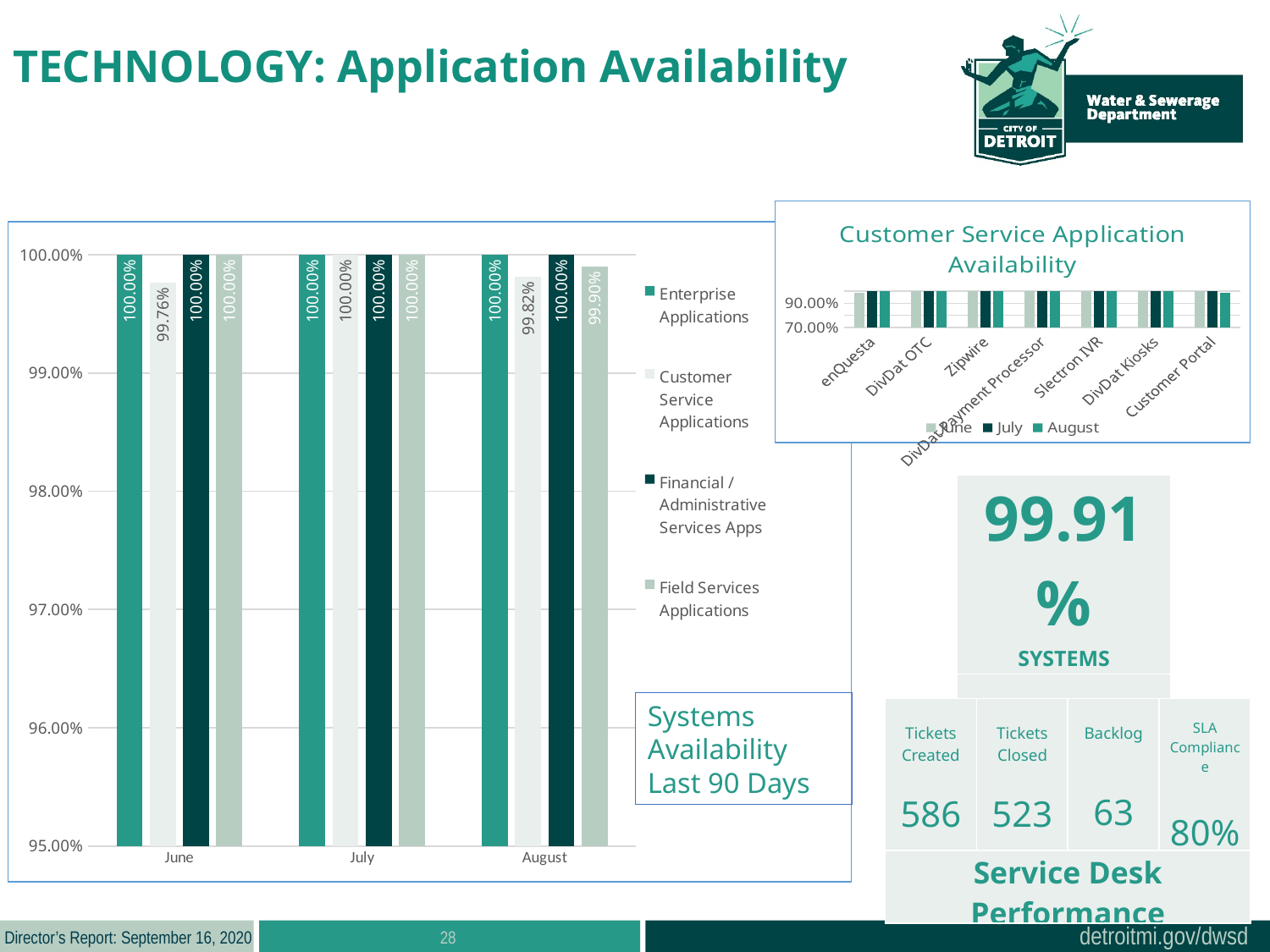
In the Systems Availability Last 90 Days chart, which series has the lowest value in June? Customer Service Applications How many applications are shown on the x axis of the Customer Service Application Availability chart? 7 How many months are shown on the x axis of the Systems Availability Last 90 Days chart? 3 In the Systems Availability Last 90 Days chart, which is larger: Customer Service Applications in June or Customer Service Applications in August? August In the Systems Availability Last 90 Days chart, what is the difference between the Field Services Applications value and the Customer Service Applications value in August? 0.08% How many series does the legend of the Systems Availability Last 90 Days chart list? 4 In the Systems Availability Last 90 Days chart, what is the value for Customer Service Applications in June? 99.76% In the Systems Availability Last 90 Days chart, what is the value for Field Services Applications in August? 99.90% What kind of chart is the Systems Availability Last 90 Days chart? bar chart In the Customer Service Application Availability chart, is the value for enQuesta in July greater or less than 90.00%? greater In the Systems Availability Last 90 Days chart, what is the value for Enterprise Applications in July? 100.00% In the Systems Availability Last 90 Days chart, what is the value for Customer Service Applications in August? 99.82%